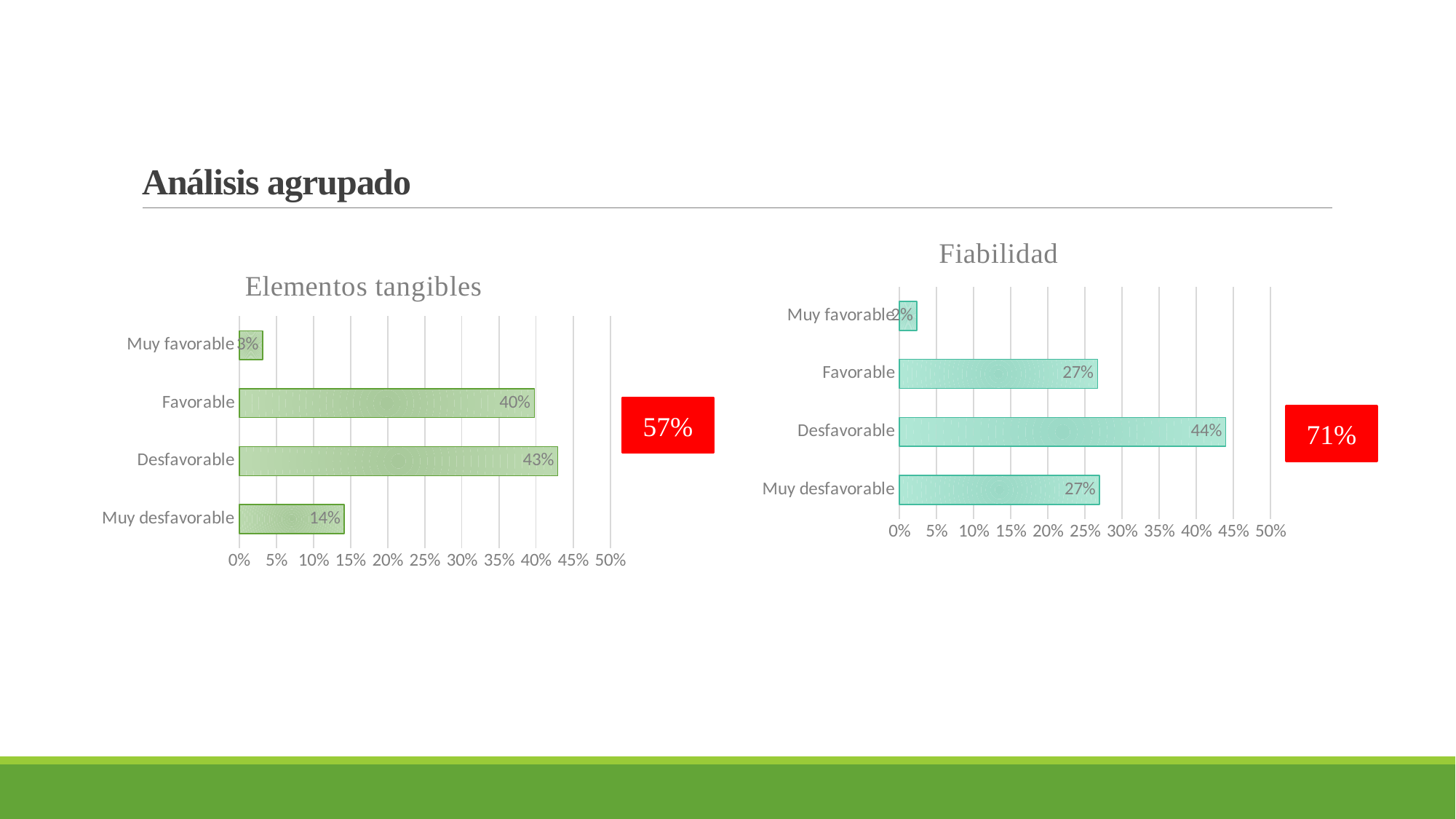
In the 'Elementos tangibles' chart, what is the difference between Desfavorable and Favorable? 3% In the 'Fiabilidad' chart, what is the difference between Desfavorable and Favorable? 17% In the 'Elementos tangibles' chart, what is the value for Favorable? 40% In the 'Elementos tangibles' chart, which category has the lowest value? Muy favorable In the 'Elementos tangibles' chart, what is the value for Muy desfavorable? 14% Which is larger: Muy desfavorable in the 'Elementos tangibles' chart or Muy desfavorable in the 'Fiabilidad' chart? Fiabilidad In the 'Fiabilidad' chart, which category has the highest value? Desfavorable How many categories does the 'Fiabilidad' chart show? 4 In the 'Fiabilidad' chart, what is the value for Desfavorable? 44% In the 'Fiabilidad' chart, what is the value for Muy favorable? 2% What kind of chart is the 'Elementos tangibles' chart? Bar chart In the 'Elementos tangibles' chart, which category has the highest value? Desfavorable